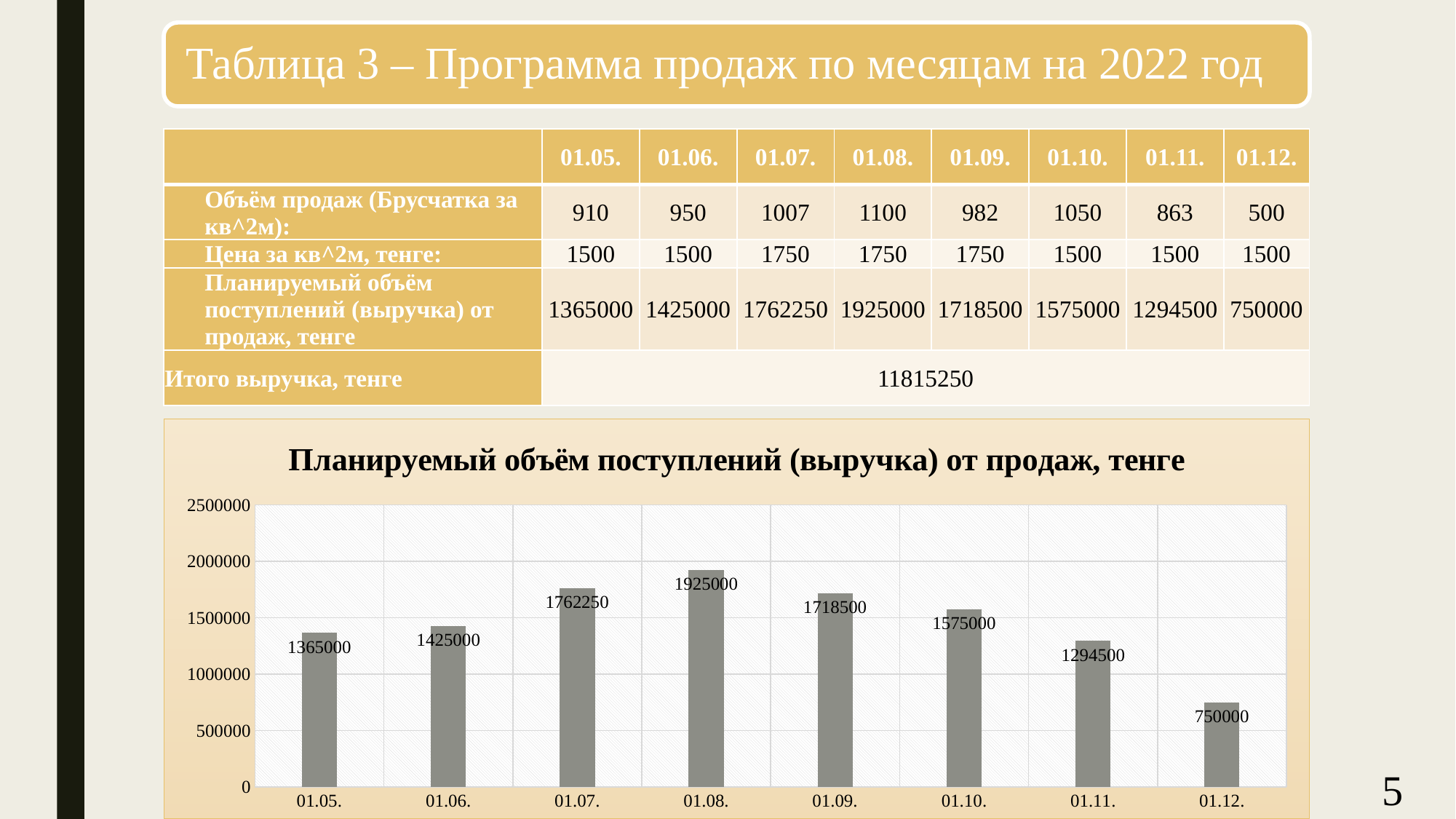
What is the difference between the values for 01.08. and 01.12.? 1175000 What is the value for 01.12. in the chart? 750000 How many months are shown on the x axis of the chart? 8 What is the value for 01.05. in the chart? 1365000 What is the value for 01.08. in the chart? 1925000 What kind of chart is shown on the slide? bar chart What is the title of the chart? Планируемый объём поступлений (выручка) от продаж, тенге Which month has the lowest value in the chart? 01.12. Which is larger, the value for 01.09. or the value for 01.10.? 01.09. Which month has the highest value in the chart? 01.08. What is the difference between the values for 01.07. and 01.06.? 337250 Is the value for 01.11. greater or less than 1500000? less